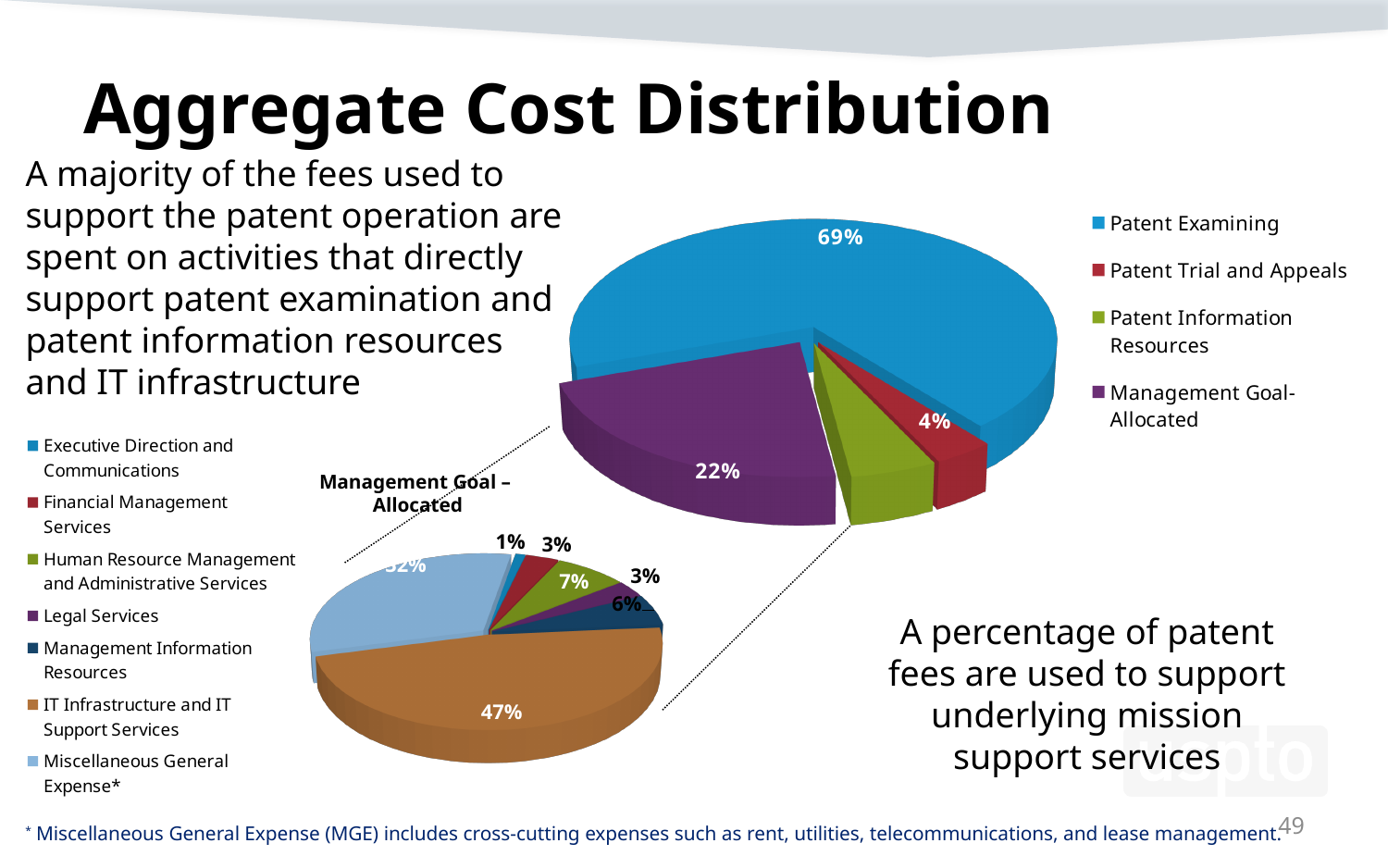
In the Aggregate Cost Distribution pie chart (upper right), what percentage is shown for Management Goal-Allocated? 22% In the Management Goal – Allocated pie chart (lower left), which category has the smallest slice? Executive Direction and Communications In the Aggregate Cost Distribution pie chart (upper right), which category has the largest slice? Patent Examining In the Aggregate Cost Distribution pie chart (upper right), what percentage is shown for Patent Trial and Appeals? 4% In the Management Goal – Allocated pie chart (lower left), which category has the largest slice? IT Infrastructure and IT Support Services In the Aggregate Cost Distribution pie chart (upper right), how many categories does the legend list? 4 In the Aggregate Cost Distribution pie chart (upper right), what percentage is shown for Patent Examining? 69% In the Aggregate Cost Distribution pie chart (upper right), which is larger: Patent Trial and Appeals or Management Goal-Allocated? Management Goal-Allocated In the Management Goal – Allocated pie chart (lower left), how many categories does the legend list? 7 In the Management Goal – Allocated pie chart (lower left), what percentage is shown for IT Infrastructure and IT Support Services? 47% What type of chart is the upper-right chart on the slide? Pie chart In the Aggregate Cost Distribution pie chart (upper right), how many percentage points larger is Patent Examining than Management Goal-Allocated? 47 percentage points